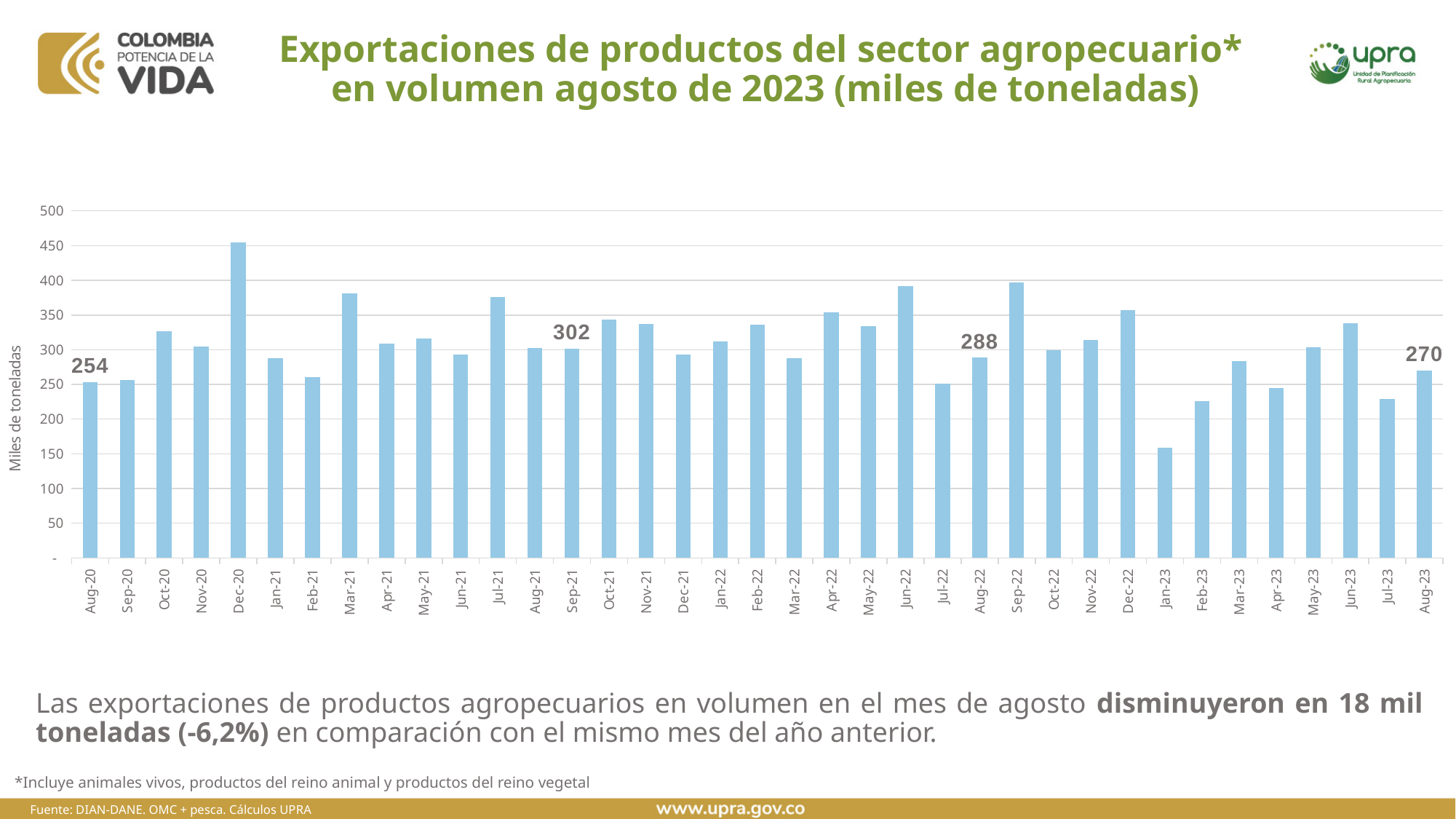
Is the value for Dec-20 greater or less than 400? greater What is the value for Aug-21? 302 What is the value for Aug-20? 254 Is the value for Jan-23 greater or less than 200? less Which month has the highest value? Dec-20 Which month has the lowest value? Jan-23 What kind of chart is shown? bar chart What is the value for Aug-22? 288 How many months are plotted on the chart? 37 What is the value for Aug-23? 270 Which is larger, the value for Aug-21 or the value for Aug-22? Aug-21 What is the difference between the values for Aug-22 and Aug-23? 18